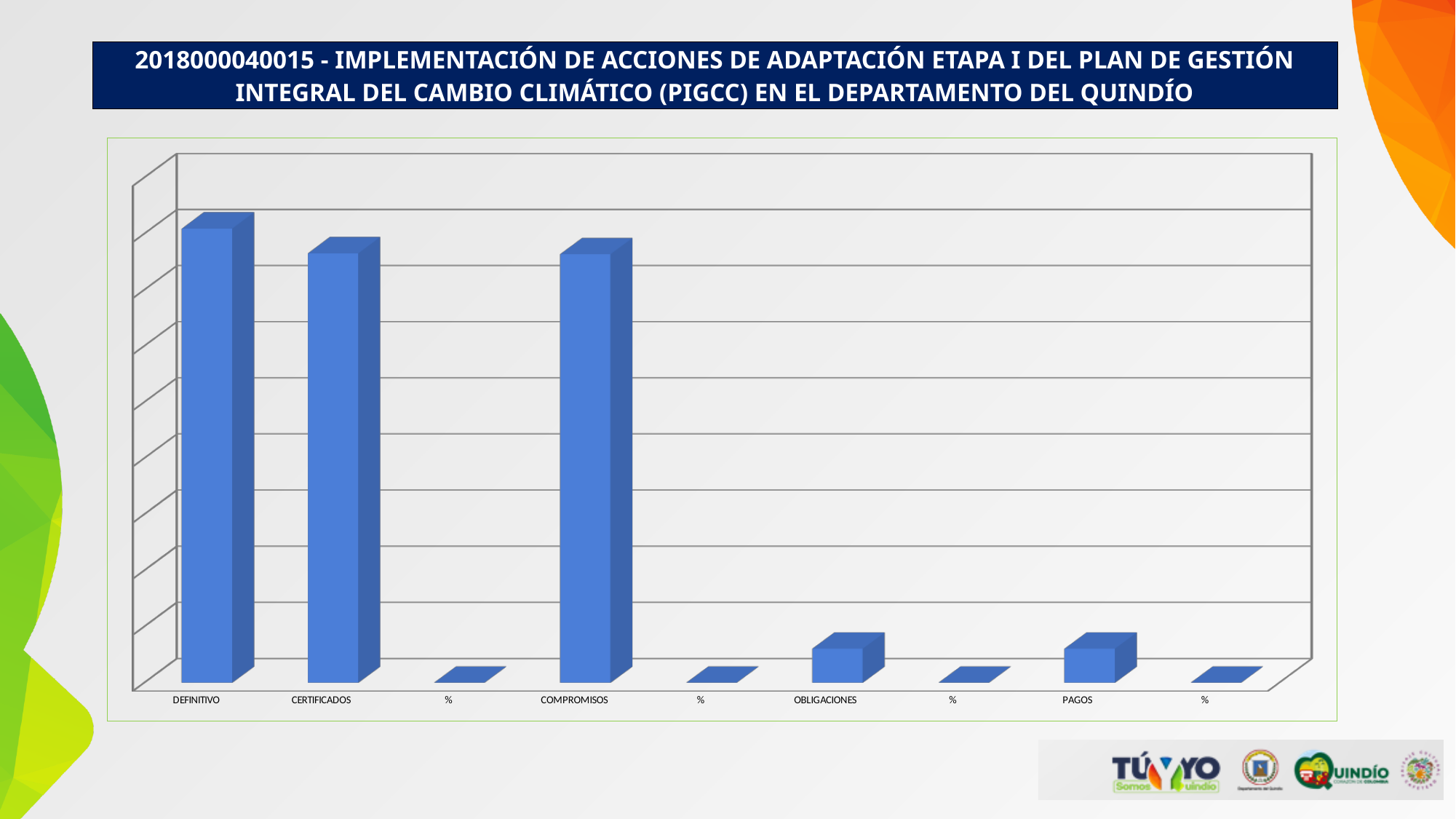
What colour are the bars in the chart? blue Which category has the tallest bar in the chart? DEFINITIVO Which bar is taller, COMPROMISOS or PAGOS? COMPROMISOS What is the first category label on the x axis of the chart? DEFINITIVO Which bar is taller, DEFINITIVO or OBLIGACIONES? DEFINITIVO What kind of chart is shown on the slide? bar chart How many categories are shown along the x axis of the chart? 9 Which bar is taller, CERTIFICADOS or OBLIGACIONES? CERTIFICADOS